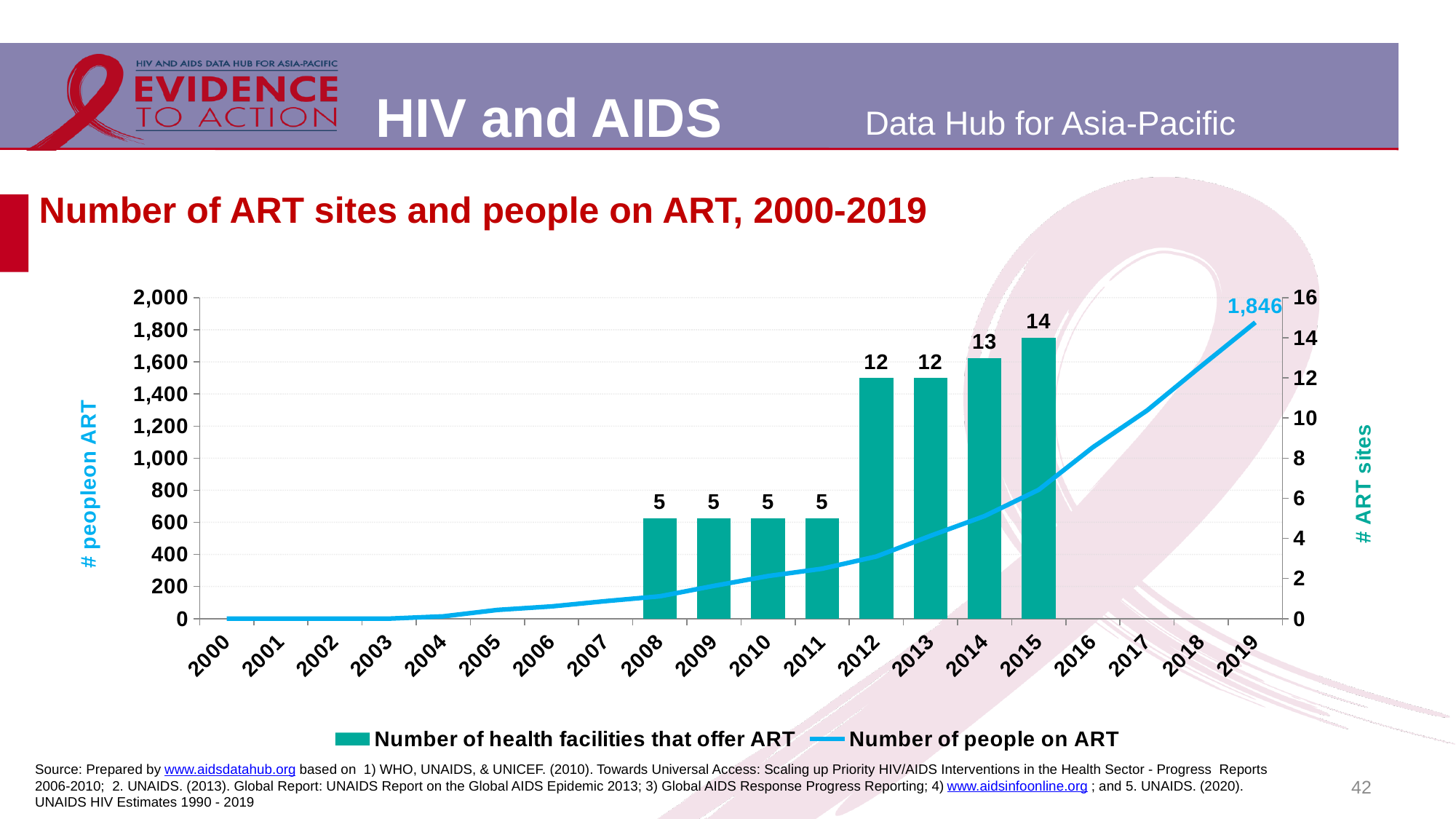
How many series does the legend list? 2 Which year had more health facilities offering ART, 2014 or 2013? 2014 What is the label of the right-hand vertical axis? # ART sites Does the number of people on ART rise or fall from 2000 to 2019? rise How many health facilities offered ART in 2012? 12 What was the number of people on ART in 2019? 1,846 How many years are shown on the x axis? 20 How many health facilities offered ART in 2015? 14 Is the number of people on ART in 2017 greater or less than 1,000? greater Which year has the highest number of health facilities that offer ART? 2015 Is the number of people on ART in 2012 greater or less than 600? less What is the difference in the number of health facilities that offer ART between 2015 and 2011? 9